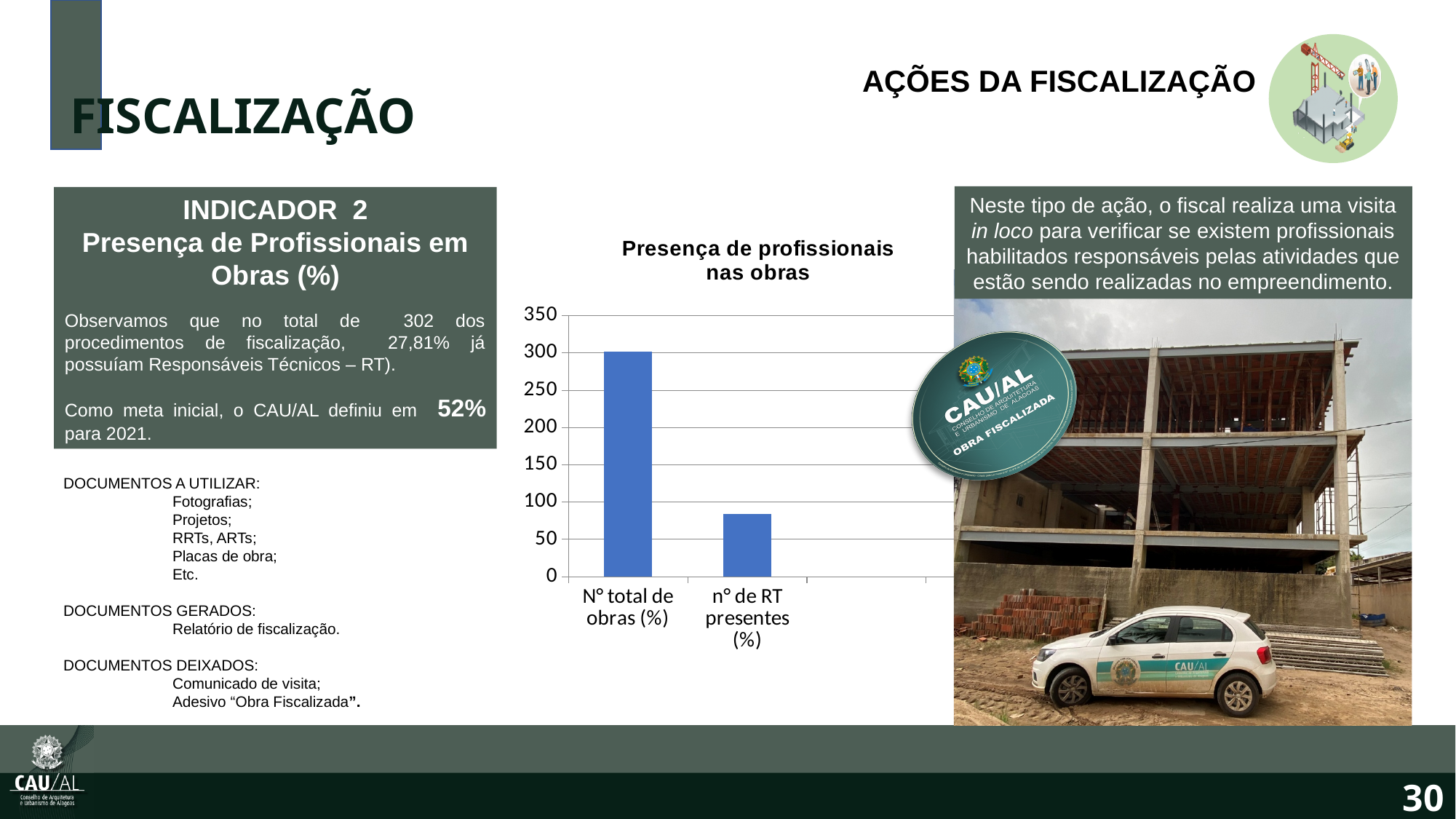
What kind of chart is shown on the slide? bar chart Is the value for n° de RT presentes (%) greater or less than 100? less Is the value for n° de RT presentes (%) greater or less than 50? greater Is the value for N° total de obras (%) greater or less than 250? greater Which is larger in the chart: the value for N° total de obras (%) or the value for n° de RT presentes (%)? N° total de obras (%) What is the highest value shown on the chart's vertical axis? 350 What is the title of the chart? Presença de profissionais nas obras Do the bar values rise or fall from left to right along the x axis? fall Which category has the lowest bar in the chart? n° de RT presentes (%) Which category has the highest bar in the chart? N° total de obras (%)